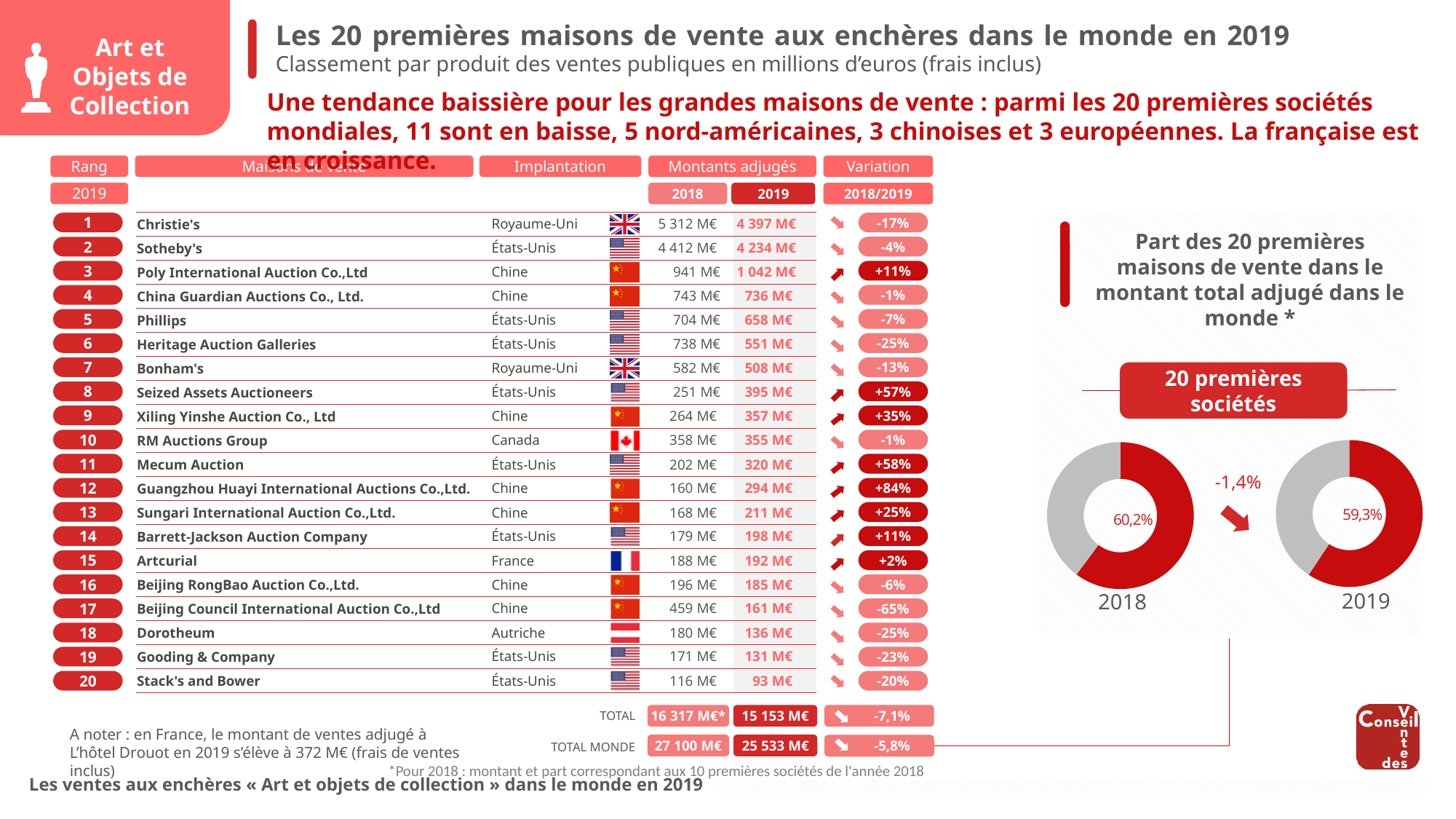
In the 2018 donut chart, what share is left for auction houses outside the top 20? 39,8% Is the 2019 share of the 20 leading auction houses greater or less than 50%? greater What kind of chart is used to show the share of the 20 leading auction houses in 2018 and 2019? pie chart (donut) In the 2019 donut chart, what share of the total amount adjudicated worldwide do the 20 leading auction houses represent? 59,3% In the 2018 donut chart, what share of the total amount adjudicated worldwide do the 20 leading auction houses represent? 60,2% Which year shows the larger share for the 20 leading auction houses, 2018 or 2019? 2018 How many donut charts are shown on the right side of the slide? 2 What colour is the slice representing the 20 leading auction houses in the donut charts? red What change is printed between the 2018 and 2019 donut charts? -1,4% What is the title above the donut charts? Part des 20 premières maisons de vente dans le montant total adjugé dans le monde * Does the share of the 20 leading auction houses rise or fall from 2018 to 2019? fall